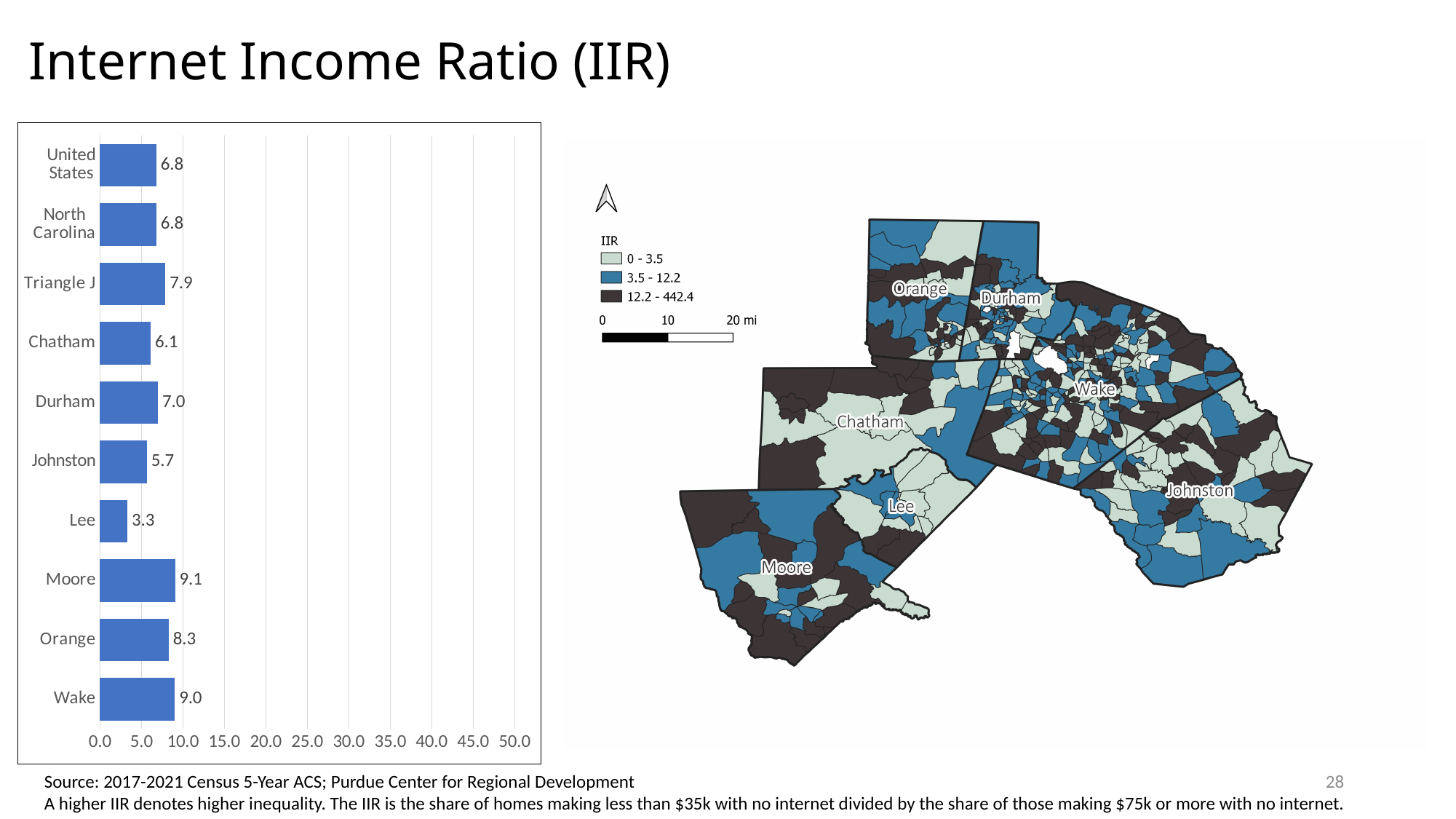
What kind of chart is shown on the left of the slide? bar chart What is the IIR value for Moore in the bar chart? 9.1 How many IIR ranges does the map legend list? 3 Which has a larger IIR value in the bar chart, Orange or Durham? Orange What is the IIR value for Lee in the bar chart? 3.3 What is the difference between the IIR values for Wake and Chatham in the bar chart? 2.9 What is the IIR value for Triangle J in the bar chart? 7.9 Which category has the lowest IIR value in the bar chart? Lee What is the highest value shown on the x axis of the bar chart? 50.0 Which category has the highest IIR value in the bar chart? Moore How many categories are shown in the bar chart? 10 Is the IIR value for Johnston in the bar chart greater or less than 10.0? less